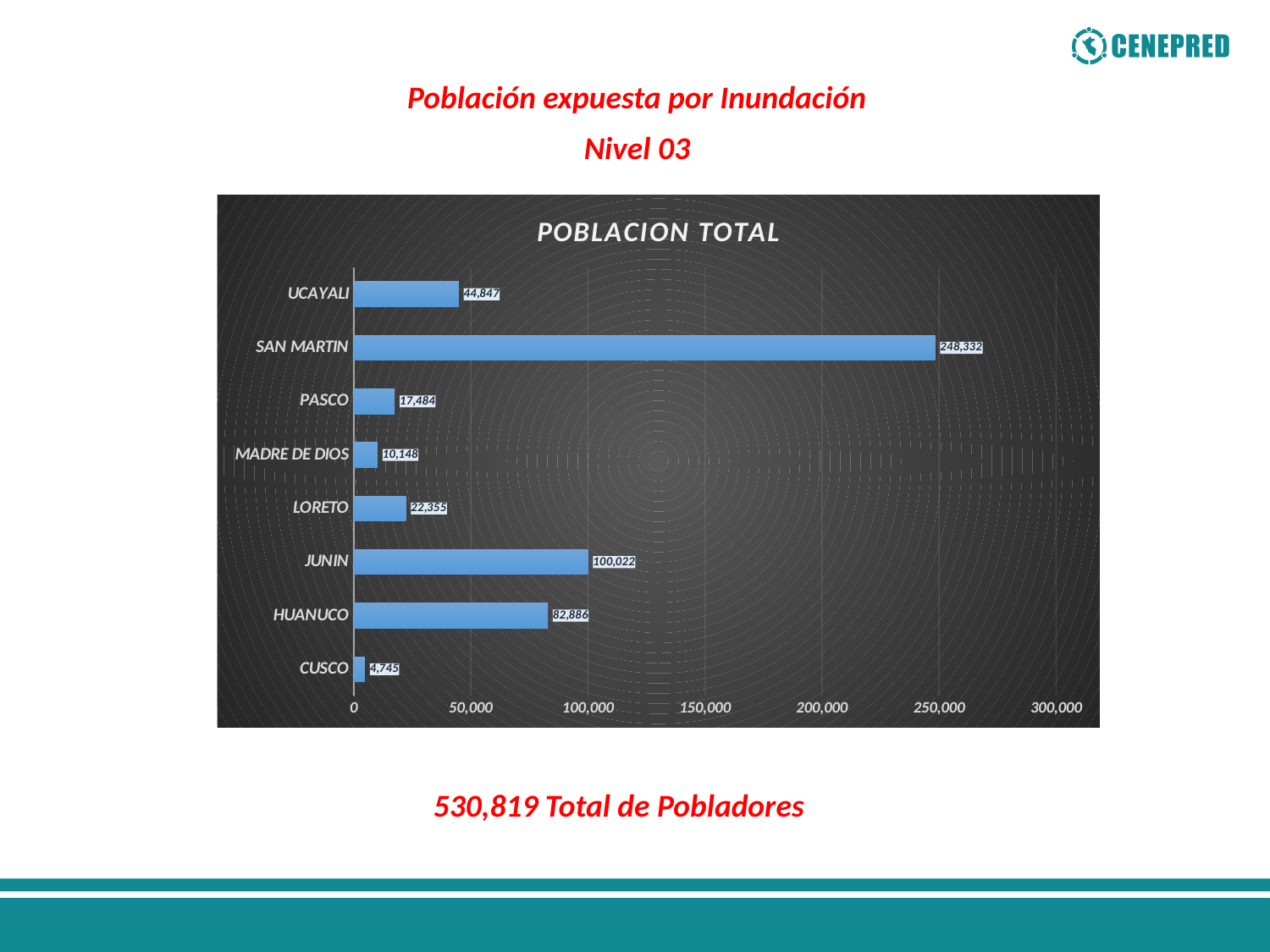
Which is larger, the value for UCAYALI or the value for LORETO? UCAYALI What is the value for JUNIN? 100,022 What kind of chart is shown on the slide? bar chart How many categories are shown in the chart? 8 What is the value for MADRE DE DIOS? 10,148 Which category has the highest value? SAN MARTIN What is the difference between the values for PASCO and CUSCO? 12,739 What is the value for SAN MARTIN? 248,332 Is the value for SAN MARTIN greater or less than 200,000? greater Which category has the lowest value? CUSCO What is the difference between the values for JUNIN and HUANUCO? 17,136 What is the title of the chart? POBLACION TOTAL